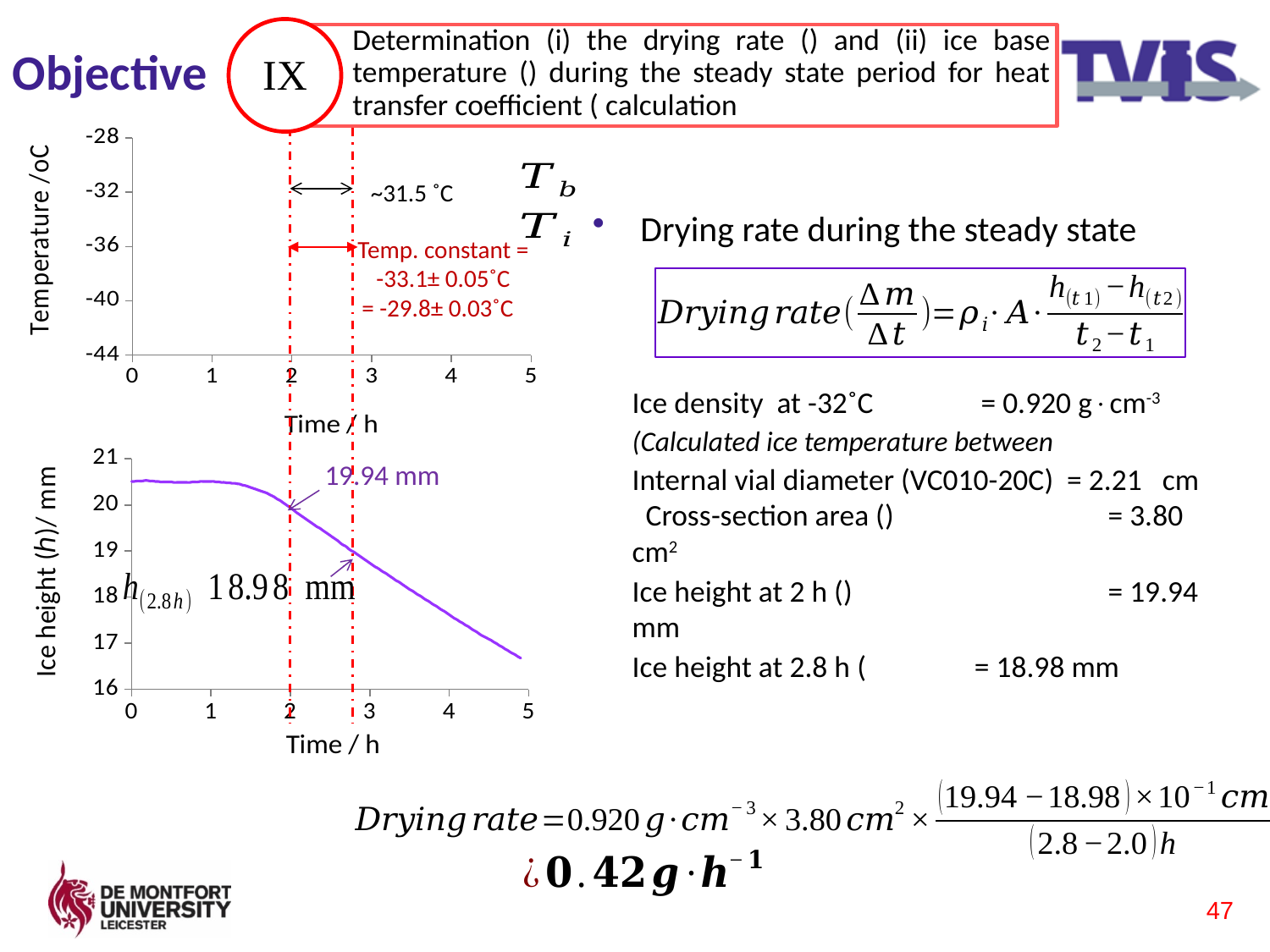
In the bottom ice height chart, what is the ice height at 2.8 h? 18.98 mm In the bottom ice height chart, which is larger: the ice height at 1 h or at 4 h? 1 h In the bottom ice height chart, is the ice height at 2.8 h greater or less than 19 mm? less In the bottom ice height chart, is the ice height at 1 h greater or less than 20 mm? greater In the bottom ice height chart, what is the difference between the ice height at 2 h and at 2.8 h? 0.96 mm In the bottom ice height chart, is the ice height at 4 h greater or less than 18 mm? less What is the y-axis label of the top chart? Temperature /oC In the bottom ice height chart, does the ice height rise or fall as time increases from 2 h to 5 h? fall In the bottom ice height chart, what is the ice height at 2 h? 19.94 mm What is the x-axis label of the bottom ice height chart? Time / h What kind of chart is the bottom chart showing ice height against time? line chart